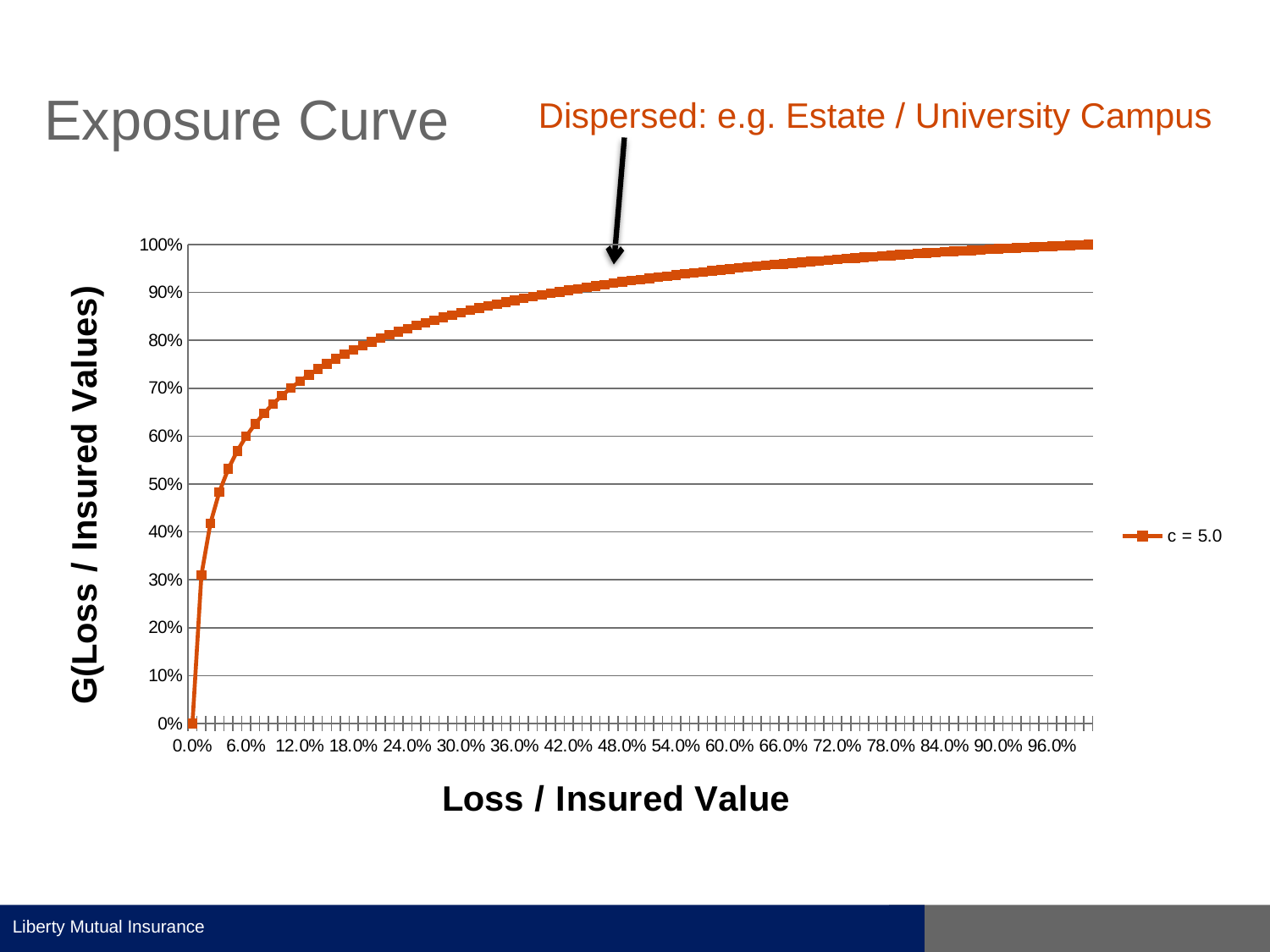
Is the value for c = 5.0 at 24.0% Loss / Insured Value greater or less than 90%? less What is the legend entry for the plotted series? c = 5.0 Is the value for c = 5.0 at 12.0% Loss / Insured Value greater or less than 60%? greater Is the value for c = 5.0 at 90.0% Loss / Insured Value greater or less than 90%? greater What kind of chart is shown on the slide? line chart Which is larger for c = 5.0: the value at 6.0% or the value at 60.0% Loss / Insured Value? 60.0% What is the title of the x axis? Loss / Insured Value How many series does the legend list? 1 Do the values of the c = 5.0 series rise or fall as Loss / Insured Value increases? rise What is the value of G(Loss / Insured Values) at a Loss / Insured Value of 0.0%? 0%